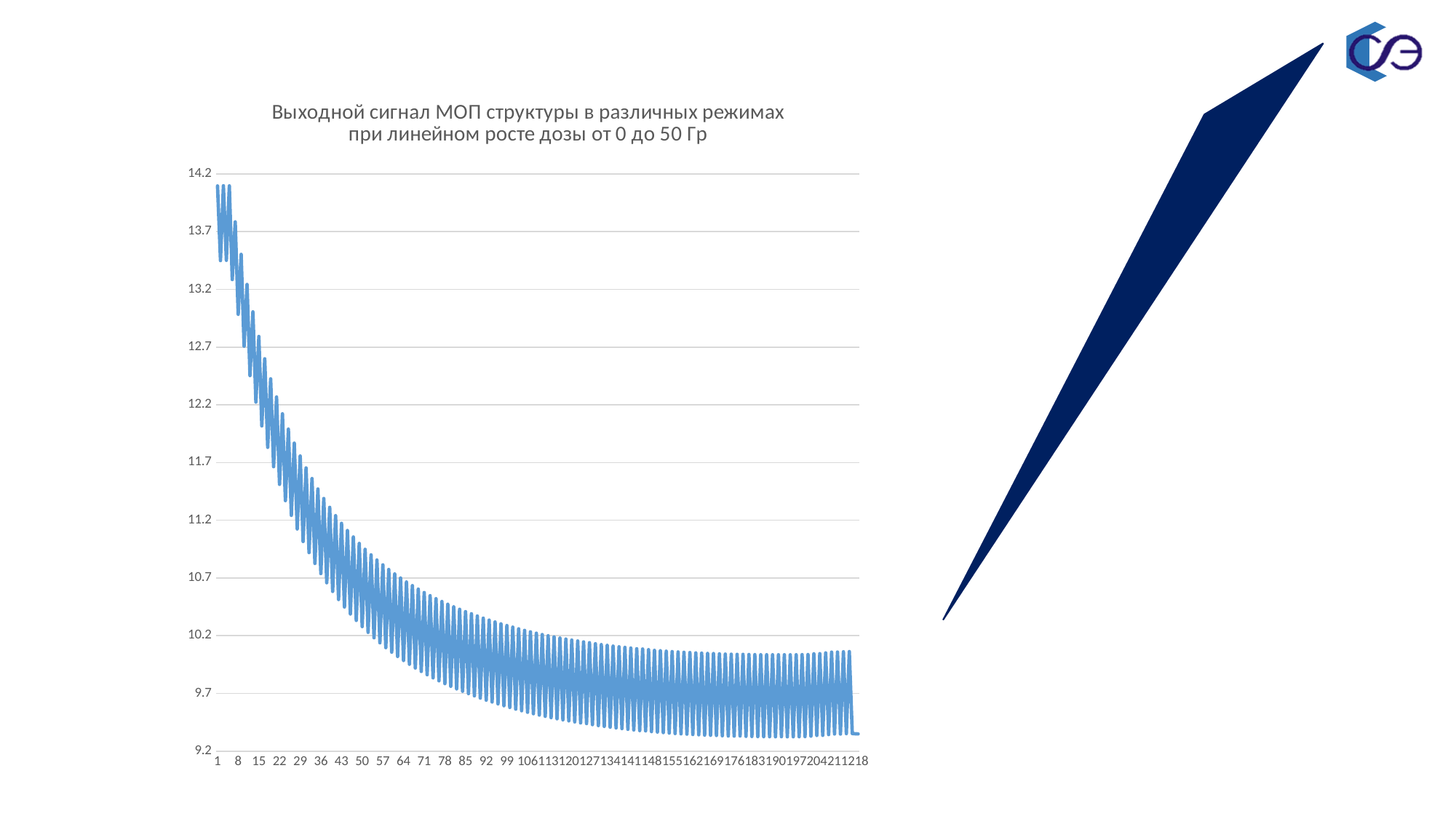
Is the value at x = 218 greater or less than 9.7? less What is the title of the chart? Выходной сигнал МОП структуры в различных режимах при линейном росте дозы от 0 до 50 Гр What is the highest value labelled on the chart's vertical axis? 14.2 Is the value at x = 106 greater or less than 11.2? less What kind of chart is shown on the slide? line chart Is the value at x = 1 greater or less than 13.2? greater Do the plotted values overall rise or fall as the x axis goes from 1 to 218? fall